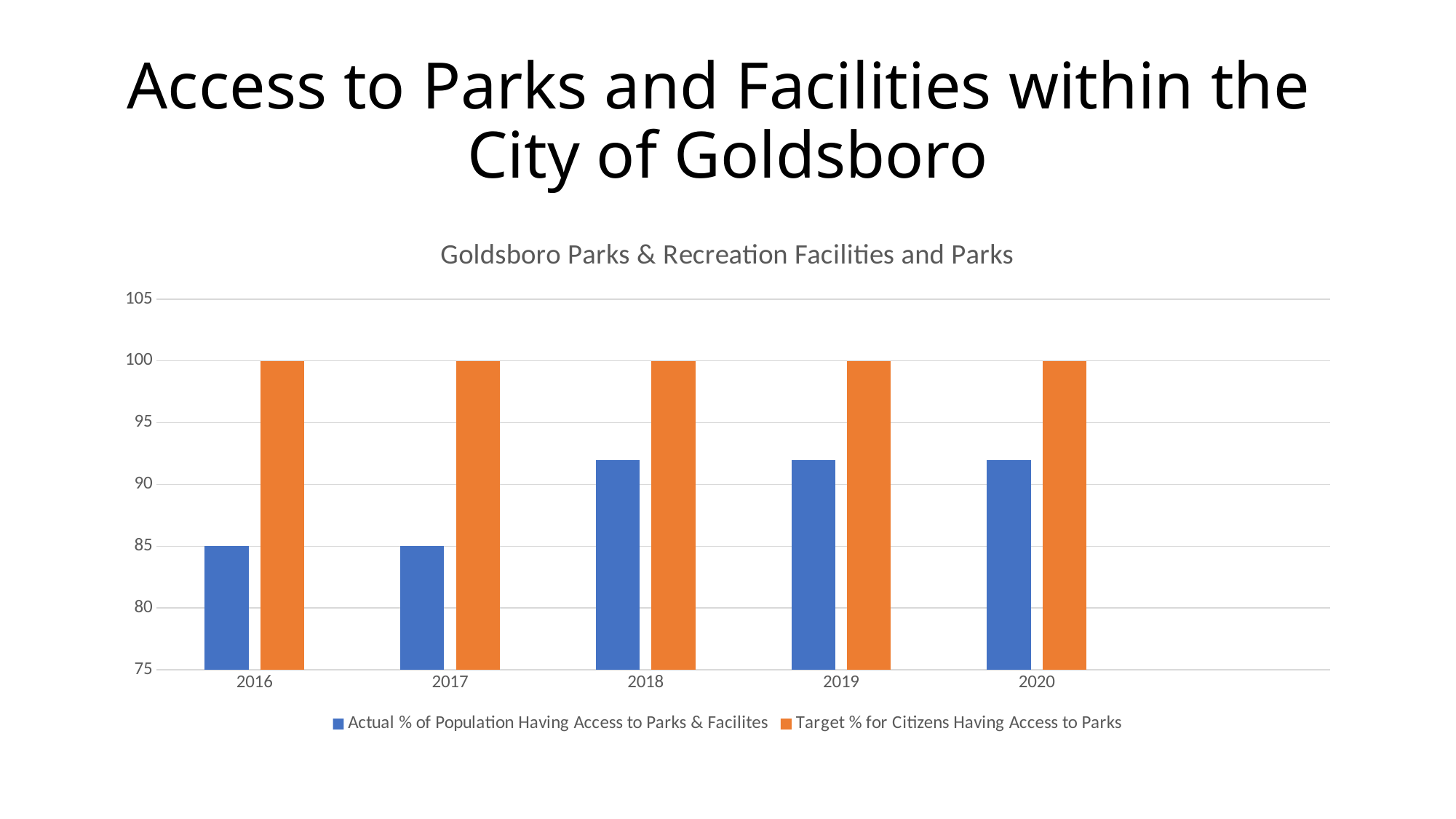
Is the Actual % of Population Having Access to Parks & Facilites in 2018 greater or less than 90? greater In 2016, which is larger: the Actual % or the Target %? Target % What kind of chart is shown on the slide? bar chart Does the Actual % of Population Having Access to Parks & Facilites rise or fall from 2016 to 2020? rise What is the Actual % of Population Having Access to Parks & Facilites in 2017? 85 What is the Actual % of Population Having Access to Parks & Facilites in 2016? 85 How many series does the legend list? 2 What is the title of the chart? Goldsboro Parks & Recreation Facilities and Parks Is the Actual % of Population Having Access to Parks & Facilites in 2019 greater or less than 95? less What is the difference between the Target % and the Actual % in 2016? 15 What is the Target % for Citizens Having Access to Parks in 2016? 100 How many years are shown on the x axis? 5